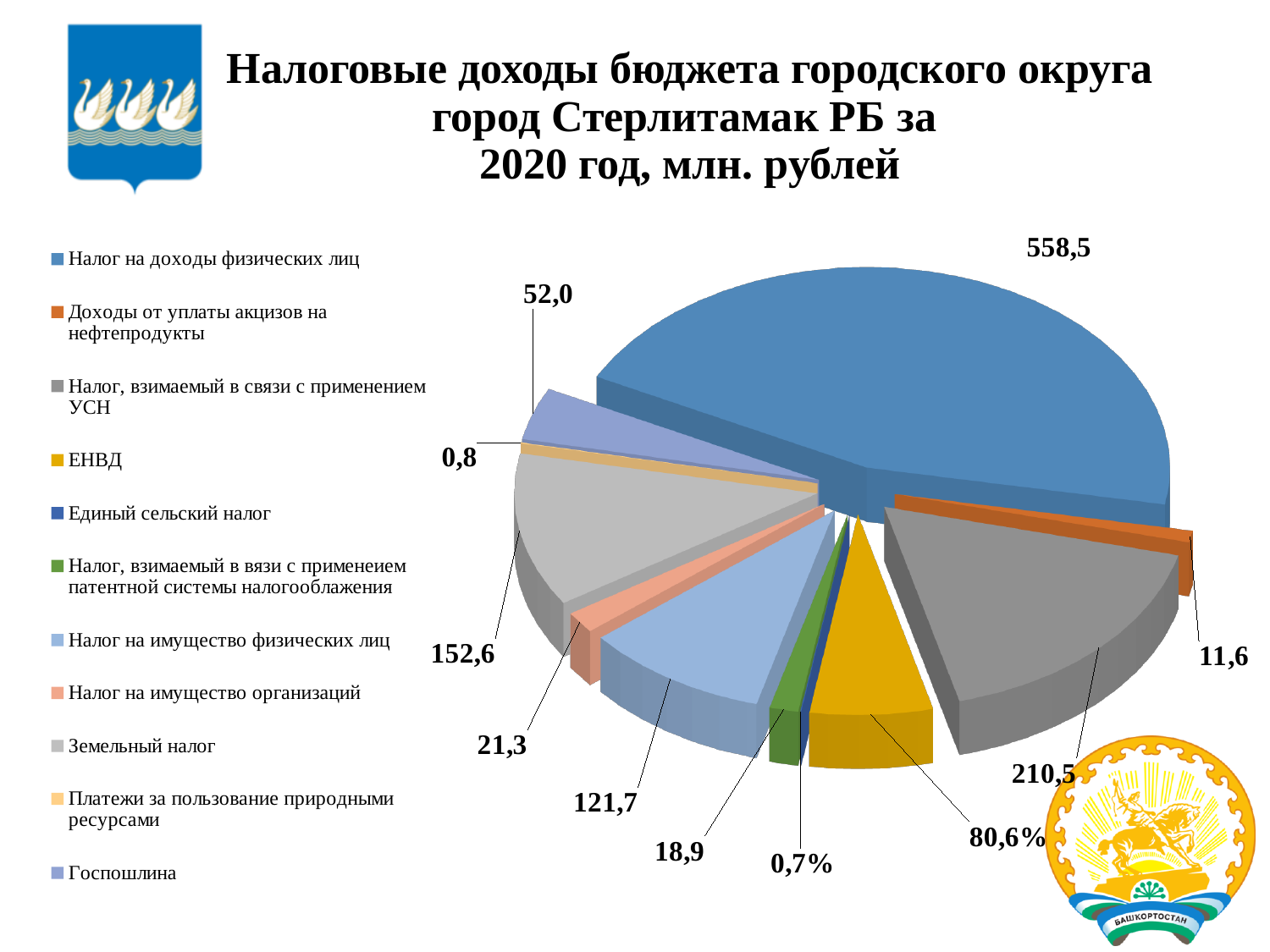
Which category has the largest slice of the pie? Налог на доходы физических лиц What year does the chart title say the data is for? 2020 What kind of chart is shown on the slide? pie chart What is the value for Земельный налог? 152,6 What is the difference between the values for Налог на доходы физических лиц and Налог, взимаемый в связи с применением УСН? 348,0 What is the value for Налог на доходы физических лиц? 558,5 What is the value for Налог на имущество физических лиц? 121,7 Which is larger: Земельный налог or Налог на имущество физических лиц? Земельный налог How many entries does the legend list? 11 What is the value for Госпошлина? 52,0 What is the value for Налог, взимаемый в связи с применением УСН? 210,5 What is the value for Доходы от уплаты акцизов на нефтепродукты? 11,6